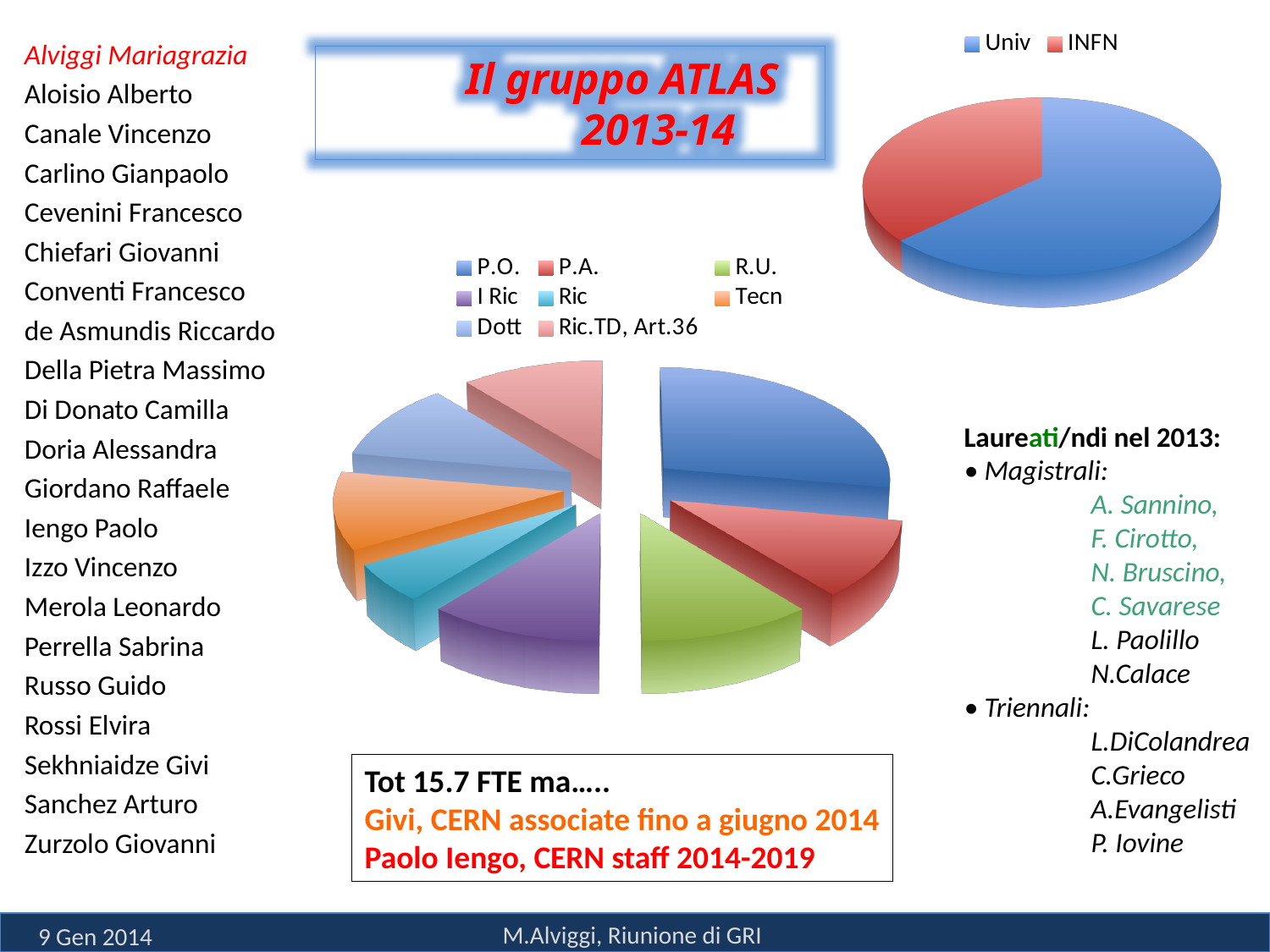
In the top-right pie chart, which category has the largest slice? Univ In the top-right pie chart, which slice is larger, Univ or INFN? Univ In the top-right pie chart, which colour represents INFN? red What kind of chart is the large chart in the centre of the slide? pie chart How many categories does the legend of the centre pie chart list? 8 What kind of chart is the chart at the top right of the slide with the Univ and INFN legend? pie chart In the centre pie chart, which slice is larger, R.U. or Ric? R.U. How many series does the legend of the top-right pie chart list? 2 In the centre pie chart, which colour represents R.U.? green In the centre pie chart, which slice is larger, P.O. or Tecn? P.O.